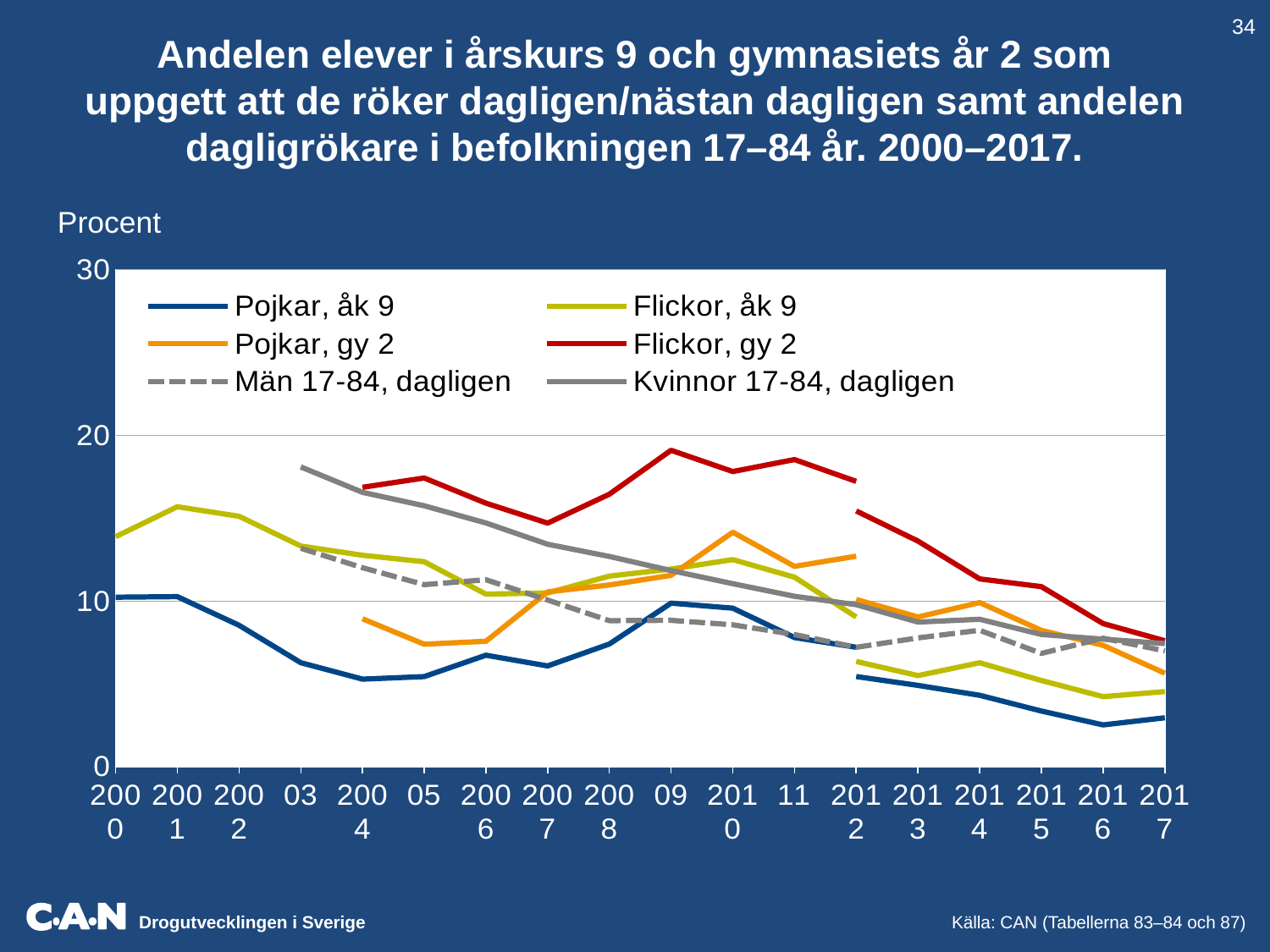
What kind of chart is shown on the slide? line chart How many years are shown along the x axis? 18 Does the Pojkar, åk 9 series rise or fall from 2000 to 2017? fall Which series has the lowest value in 2017? Pojkar, åk 9 How many series does the legend list? 6 Is the value for Pojkar, åk 9 in 2004 greater or less than 10? less What label is shown above the y axis? Procent Which series has the highest value in 2009? Flickor, gy 2 Is the value for Flickor, gy 2 in 2009 greater or less than 10? greater Which series is drawn with a dashed line? Män 17-84, dagligen Is the value for Flickor, åk 9 in 2001 greater or less than 10? greater